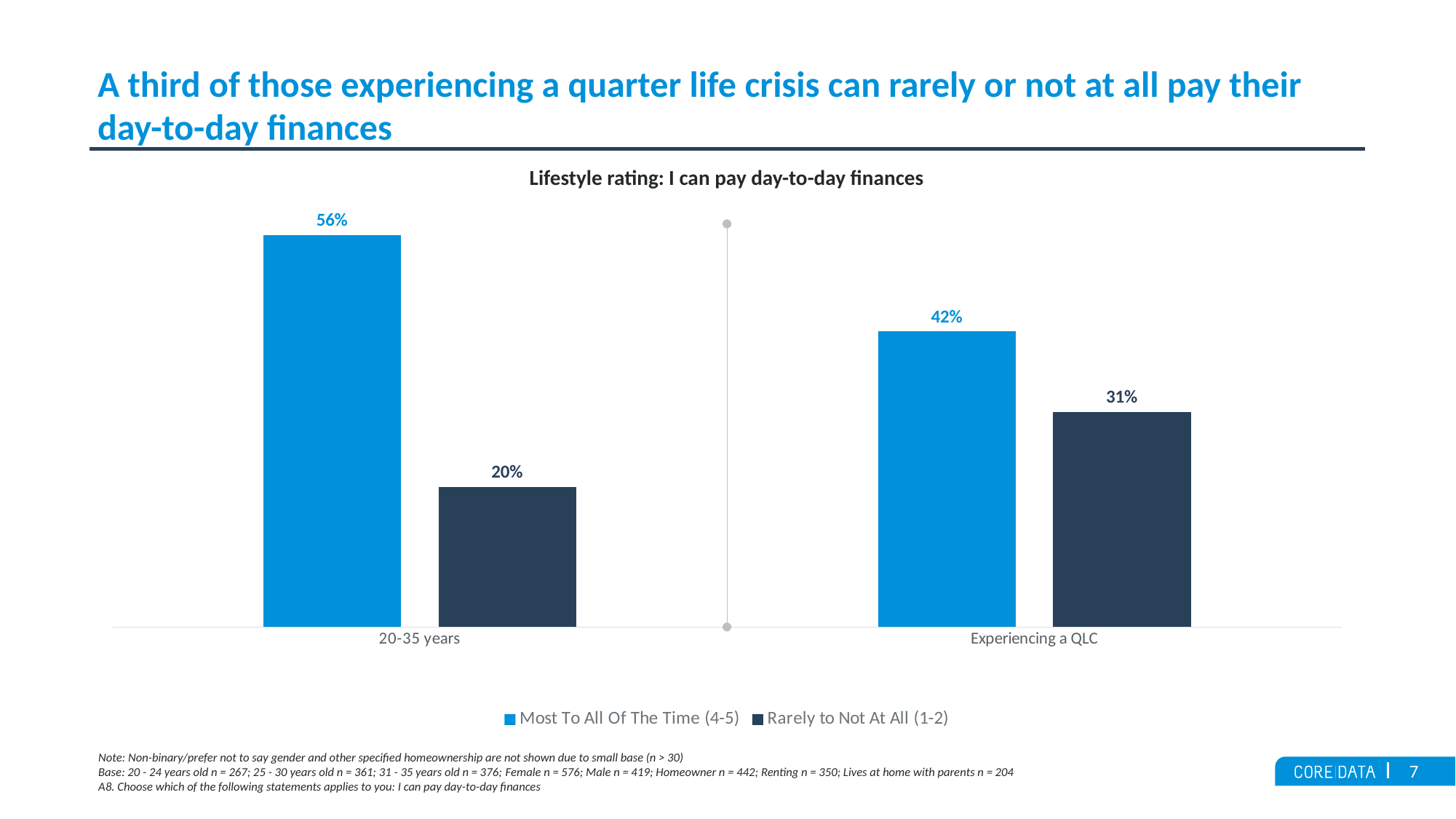
Which category has the lowest value for 'Rarely to Not At All (1-2)'? 20-35 years What kind of chart is shown on the slide? Bar chart What is the value for 'Rarely to Not At All (1-2)' in the Experiencing a QLC category? 31% How many categories are shown on the x axis? 2 What is the value for 'Most To All Of The Time (4-5)' in the Experiencing a QLC category? 42% Which is larger: 'Most To All Of The Time (4-5)' for Experiencing a QLC or 'Rarely to Not At All (1-2)' for Experiencing a QLC? Most To All Of The Time (4-5) What is the difference between the 'Most To All Of The Time (4-5)' values for 20-35 years and Experiencing a QLC? 14% What is the value for 'Most To All Of The Time (4-5)' in the 20-35 years category? 56% Which category has the highest value for 'Most To All Of The Time (4-5)'? 20-35 years How many series does the legend list? 2 What is the value for 'Rarely to Not At All (1-2)' in the 20-35 years category? 20% What is the difference between the 'Rarely to Not At All (1-2)' values for Experiencing a QLC and 20-35 years? 11%